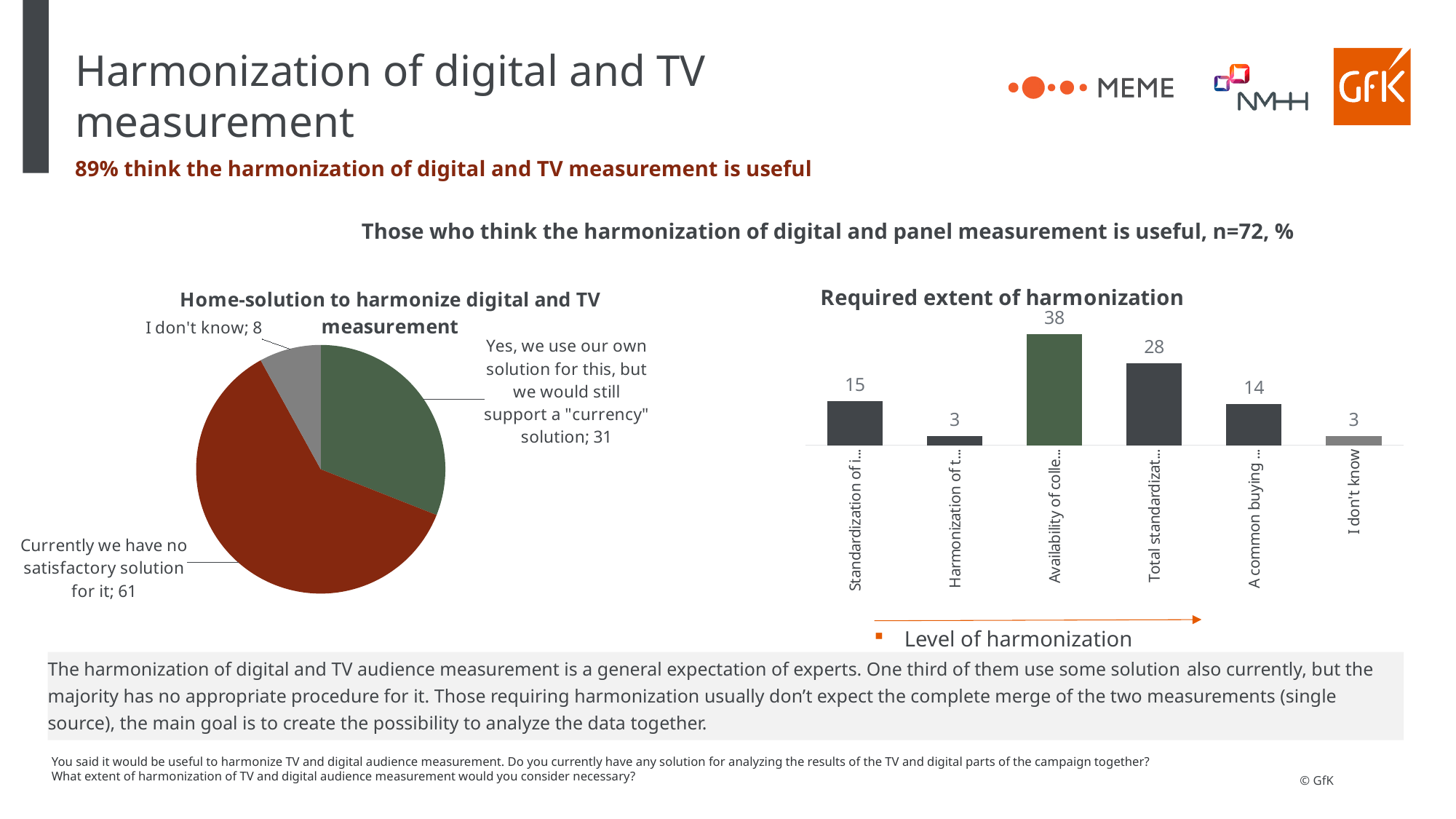
How many slices does the pie chart 'Home-solution to harmonize digital and TV measurement' have? 3 What type of chart is 'Required extent of harmonization'? bar chart In the bar chart 'Required extent of harmonization', what is the value of the tallest bar? 38 In the bar chart 'Required extent of harmonization', what is the value of the fourth bar from the left? 28 In the bar chart 'Required extent of harmonization', what is the value for 'I don't know'? 3 In the bar chart 'Required extent of harmonization', which is larger: the first bar from the left or the fifth bar from the left? the first bar (15) In the pie chart 'Home-solution to harmonize digital and TV measurement', what is the value for 'Currently we have no satisfactory solution for it'? 61 In the pie chart 'Home-solution to harmonize digital and TV measurement', which slice is the largest? Currently we have no satisfactory solution for it In the pie chart 'Home-solution to harmonize digital and TV measurement', what is the difference between 'Currently we have no satisfactory solution for it' and 'Yes, we use our own solution for this, but we would still support a "currency" solution'? 30 In the pie chart 'Home-solution to harmonize digital and TV measurement', what is the value for 'I don't know'? 8 In the bar chart 'Required extent of harmonization', what is the difference between the third bar (38) and the fourth bar (28)? 10 In the bar chart 'Required extent of harmonization', how many bars are there? 6